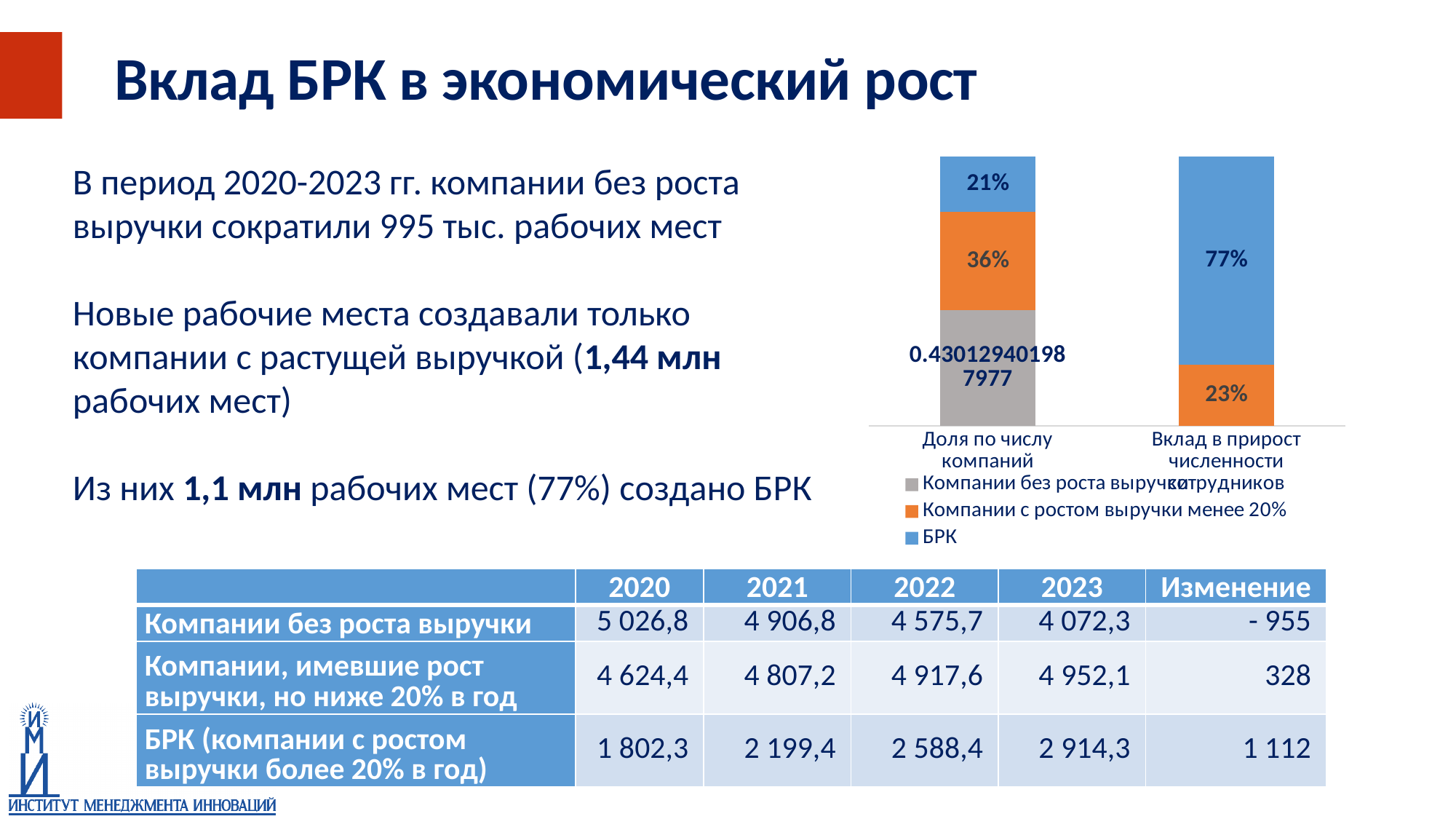
In the stacked bar chart, what is the value of the БРК segment for "Доля по числу компаний"? 21% In the stacked bar chart, what is the value of the БРК segment for "Вклад в прирост численности сотрудников"? 77% In the stacked bar chart, what is the value of the "Компании с ростом выручки менее 20%" segment for "Доля по числу компаний"? 36% How many series does the legend of the stacked bar chart list? 3 How many categories are shown on the x axis of the stacked bar chart? 2 In the stacked bar chart, what is the difference between the БРК segment (77%) and the "Компании с ростом выручки менее 20%" segment (23%) in the "Вклад в прирост численности сотрудников" bar? 54 percentage points In the stacked bar chart, which colour represents БРК in the legend? Blue In the stacked bar chart, is the БРК value larger for "Доля по числу компаний" or for "Вклад в прирост численности сотрудников"? Вклад в прирост численности сотрудников In the stacked bar chart, what is the value of the "Компании с ростом выручки менее 20%" segment for "Вклад в прирост численности сотрудников"? 23% In the stacked bar chart, which segment is the largest in the "Вклад в прирост численности сотрудников" bar? БРК What kind of chart is shown on the slide? Stacked bar chart In the stacked bar chart, which segment is the largest in the "Доля по числу компаний" bar? Компании без роста выручки